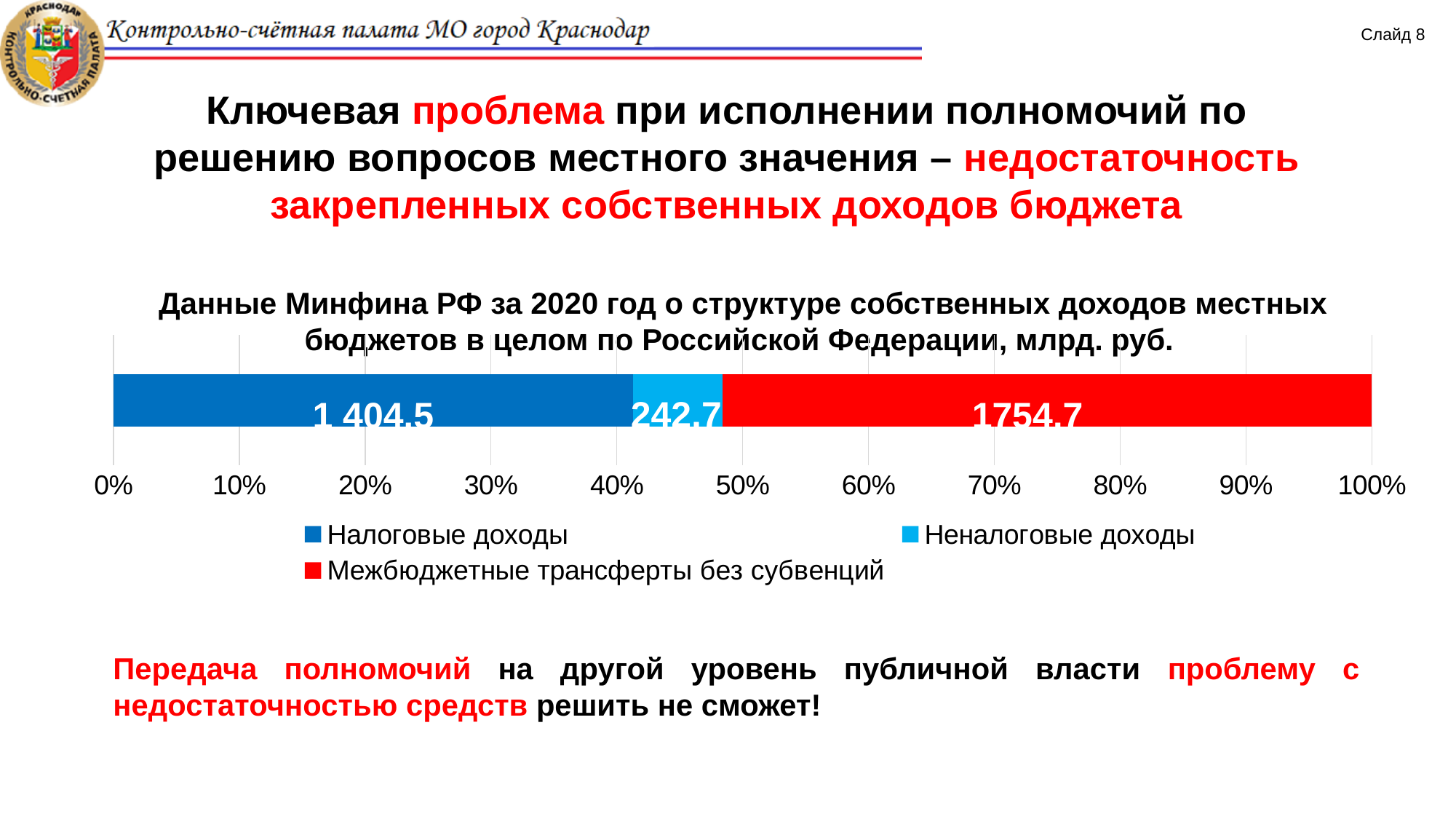
What is the total of all three segments of the stacked bar? 3401.9 Which is larger: Налоговые доходы or Неналоговые доходы? Налоговые доходы What is the value for Налоговые доходы on the chart? 1 404.5 What kind of chart is shown on the slide? Stacked bar chart What is the value for Неналоговые доходы on the chart? 242.7 How many series does the legend list? 3 What colour represents Межбюджетные трансферты без субвенций in the chart? Red Which series has the largest value on the chart? Межбюджетные трансферты без субвенций What is the value for Межбюджетные трансферты без субвенций on the chart? 1754.7 Is the share of the bar taken by Неналоговые доходы greater or less than 10%? less Which series has the smallest value on the chart? Неналоговые доходы What is the difference between Межбюджетные трансферты без субвенций and Налоговые доходы? 350.2